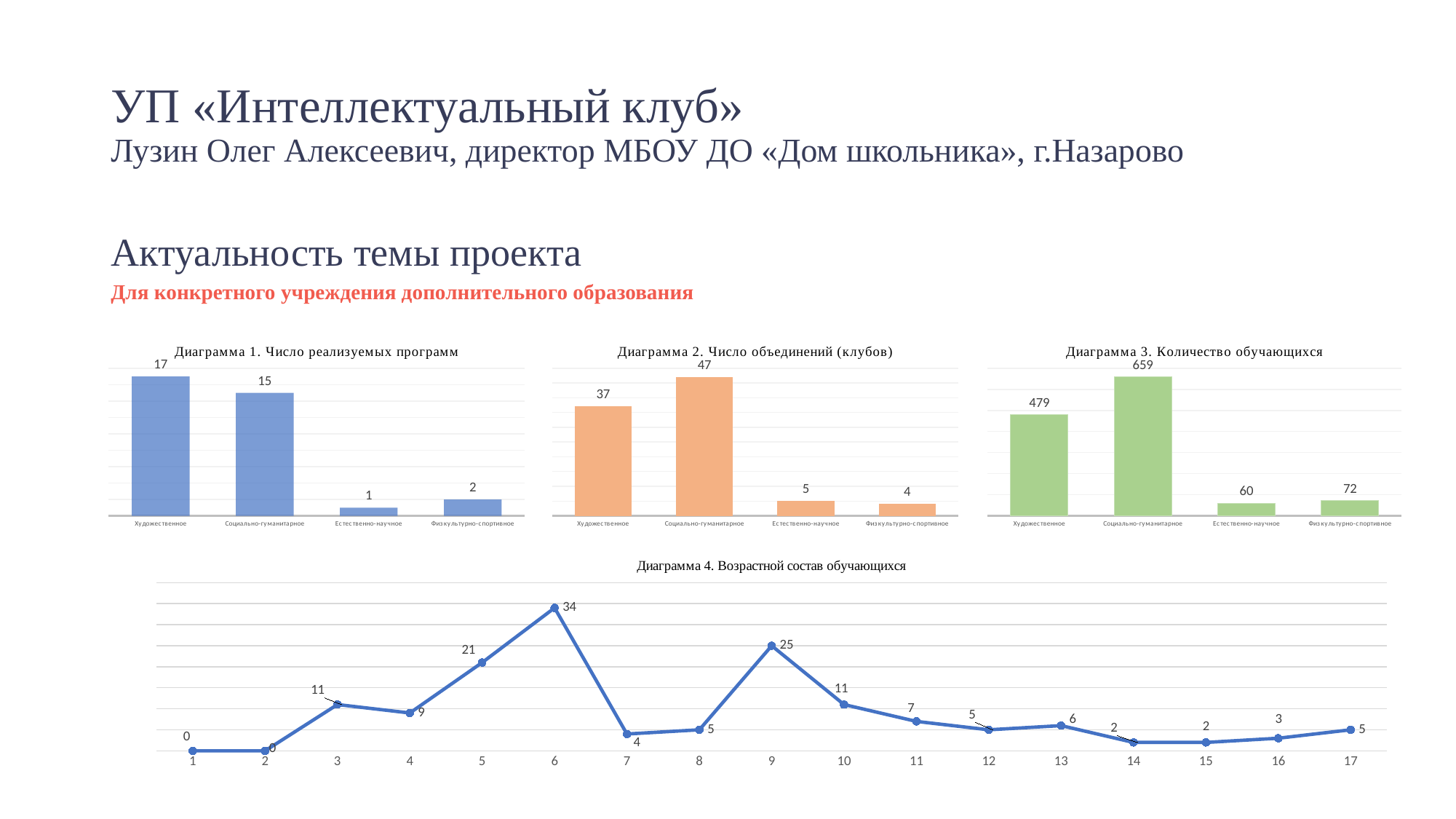
What kind of chart is Диаграмма 4. Возрастной состав обучающихся? line chart In Диаграмма 1. Число реализуемых программ, which category has the lowest value? Естественно-научное In Диаграмма 3. Количество обучающихся, which category has the highest value? Социально-гуманитарное In Диаграмма 3. Количество обучающихся, which is larger: Естественно-научное or Физкультурно-спортивное? Физкультурно-спортивное In Диаграмма 2. Число объединений (клубов), what is the difference between Художественное and Социально-гуманитарное? 10 In Диаграмма 1. Число реализуемых программ, what is the value for Художественное? 17 How many categories does Диаграмма 1. Число реализуемых программ show? 4 In Диаграмма 4. Возрастной состав обучающихся, how many points are plotted? 17 In Диаграмма 2. Число объединений (клубов), what is the value for Социально-гуманитарное? 47 In Диаграмма 3. Количество обучающихся, what is the value for Естественно-научное? 60 In Диаграмма 4. Возрастной состав обучающихся, what is the difference between the values at x = 9 and x = 10? 14 In Диаграмма 4. Возрастной состав обучающихся, what is the value at x = 6? 34